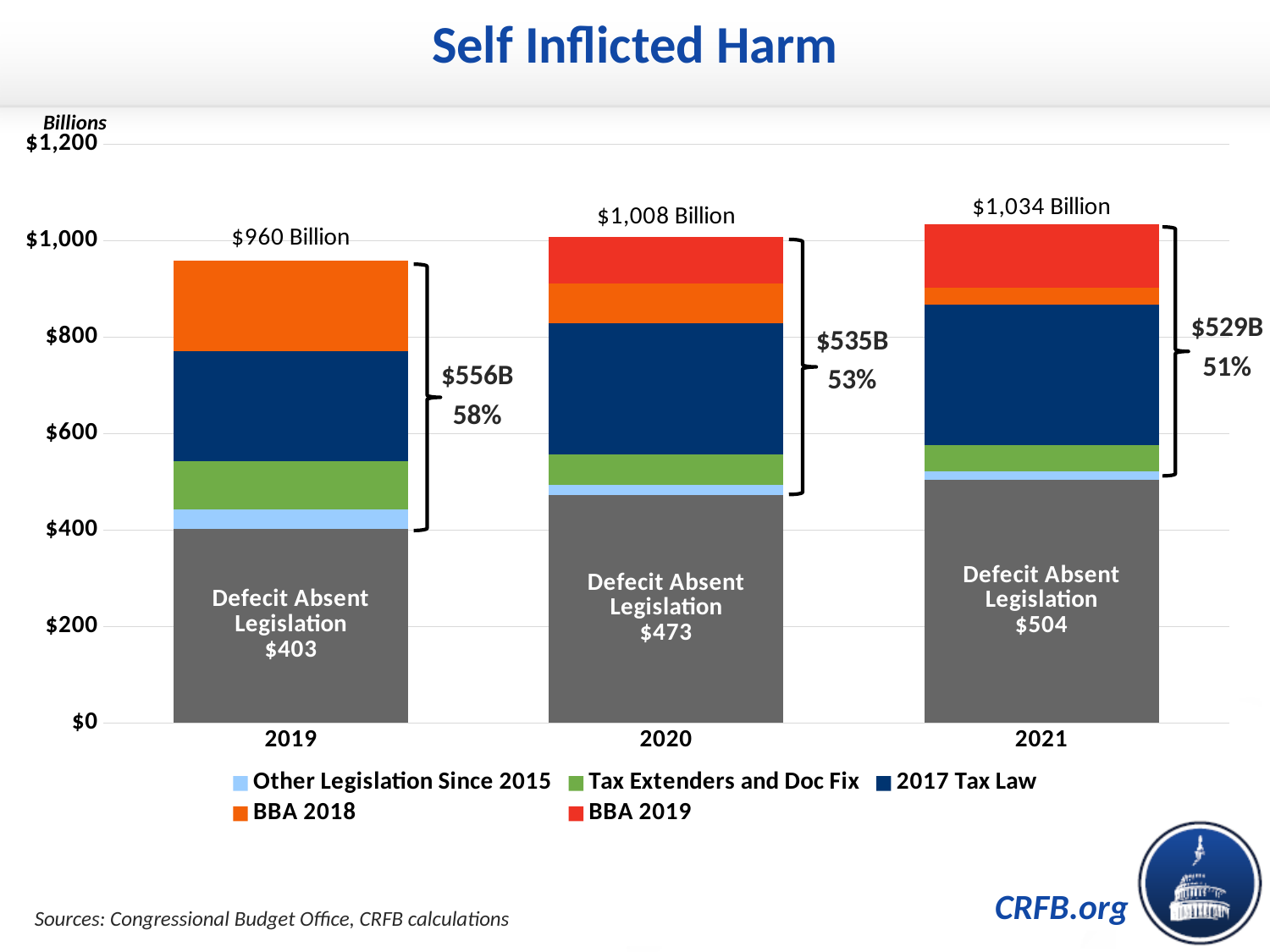
What is the total deficit shown for 2019? $960 Billion How many years are shown on the x axis? 3 Which is larger, the Deficit Absent Legislation in 2019 or in 2021? 2021 What is the dollar amount of the legislation portion for 2020, as shown by the bracket label? $535B What is the value of Deficit Absent Legislation for 2020? $473 Which year has the lowest total deficit? 2019 How many series does the legend list? 5 What is the total deficit shown for 2021? $1,034 Billion What is the difference between the total deficit in 2021 and in 2019? $74 Billion Which year has the highest total deficit? 2021 What kind of chart is shown on the slide? Stacked bar chart What share of the 2019 deficit is attributed to legislation, according to the bracket label? 58%